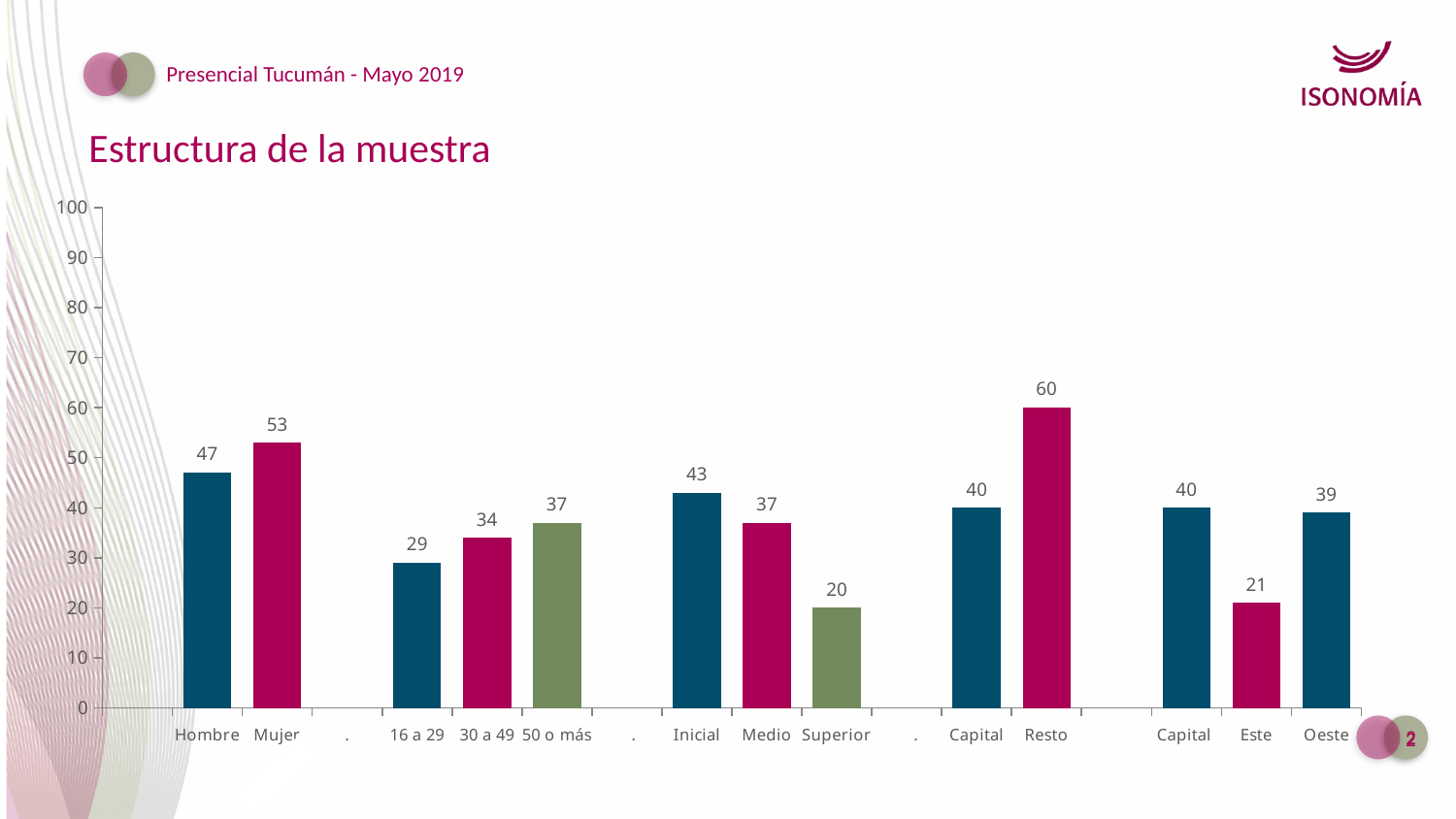
What is the value for Resto? 60 Which category has the lowest value in the chart? Superior Is the value for Resto greater or less than 50? greater What is the title of the chart? Estructura de la muestra What kind of chart is shown on the slide? bar chart What is the value for Este? 21 Which is larger, the value for Inicial or the value for Medio? Inicial What is the value for Superior? 20 Which category has the highest value in the chart? Resto What is the value for 16 a 29? 29 What is the difference between the values for Mujer and Hombre? 6 What is the value for Mujer? 53